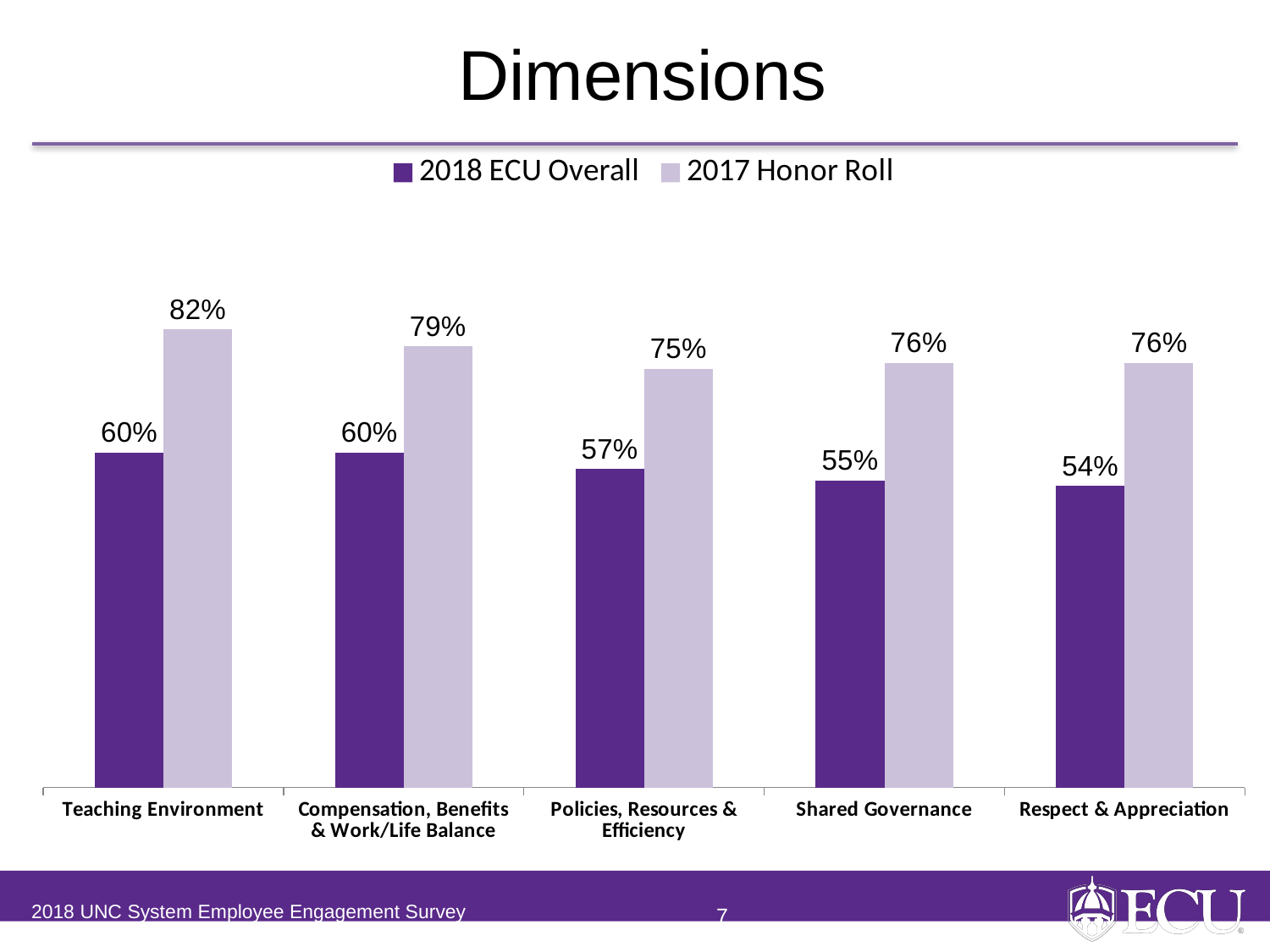
How many categories are shown on the x axis? 5 What is the title of the chart? Dimensions Which category has the lowest 2018 ECU Overall value? Respect & Appreciation Which category has the highest 2017 Honor Roll value? Teaching Environment Which is larger for Shared Governance: the 2018 ECU Overall value or the 2017 Honor Roll value? 2017 Honor Roll What is the 2018 ECU Overall value for Teaching Environment? 60% What is the difference between the 2017 Honor Roll and 2018 ECU Overall values for Teaching Environment? 22% How many series does the legend list? 2 What is the 2018 ECU Overall value for Respect & Appreciation? 54% What kind of chart is shown on the slide? Bar chart What is the difference between the 2017 Honor Roll and 2018 ECU Overall values for Shared Governance? 21% What is the 2017 Honor Roll value for Policies, Resources & Efficiency? 75%